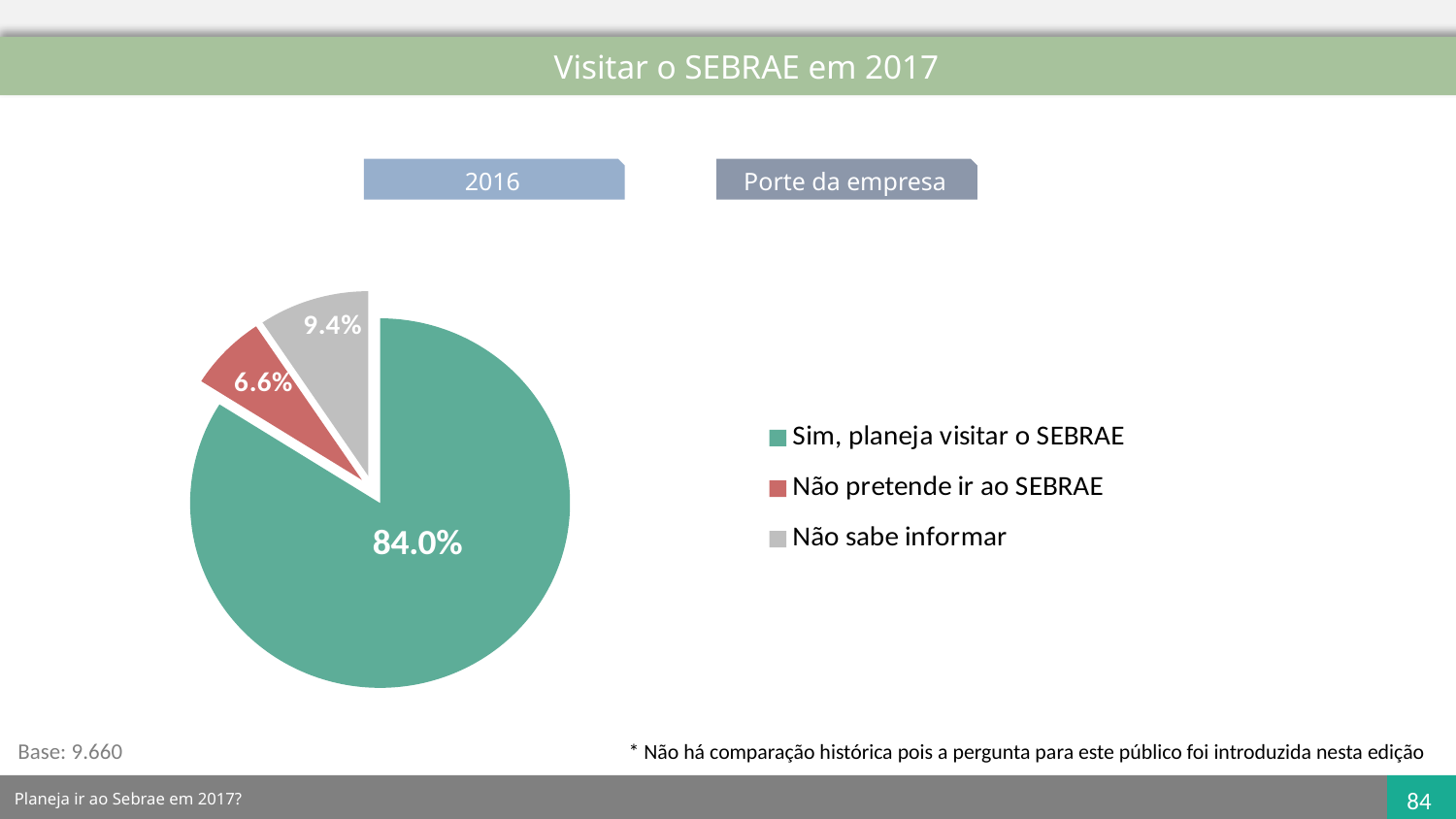
What share of the pie is labelled "Não pretende ir ao SEBRAE"? 6.6% Which category has the smallest slice of the pie? Não pretende ir ao SEBRAE What is the difference in percentage points between "Não sabe informar" and "Não pretende ir ao SEBRAE"? 2.8 What is the base (number of respondents) shown on the slide? 9.660 Which is larger: the slice for "Não sabe informar" or the slice for "Não pretende ir ao SEBRAE"? Não sabe informar How many slices does the pie chart have? 3 What kind of chart is shown on the slide? pie chart Which category has the largest slice of the pie? Sim, planeja visitar o SEBRAE What share of the pie is labelled "Não sabe informar"? 9.4% What colour is the slice for "Sim, planeja visitar o SEBRAE"? green How many entries does the legend list? 3 What share of the pie is labelled "Sim, planeja visitar o SEBRAE"? 84.0%